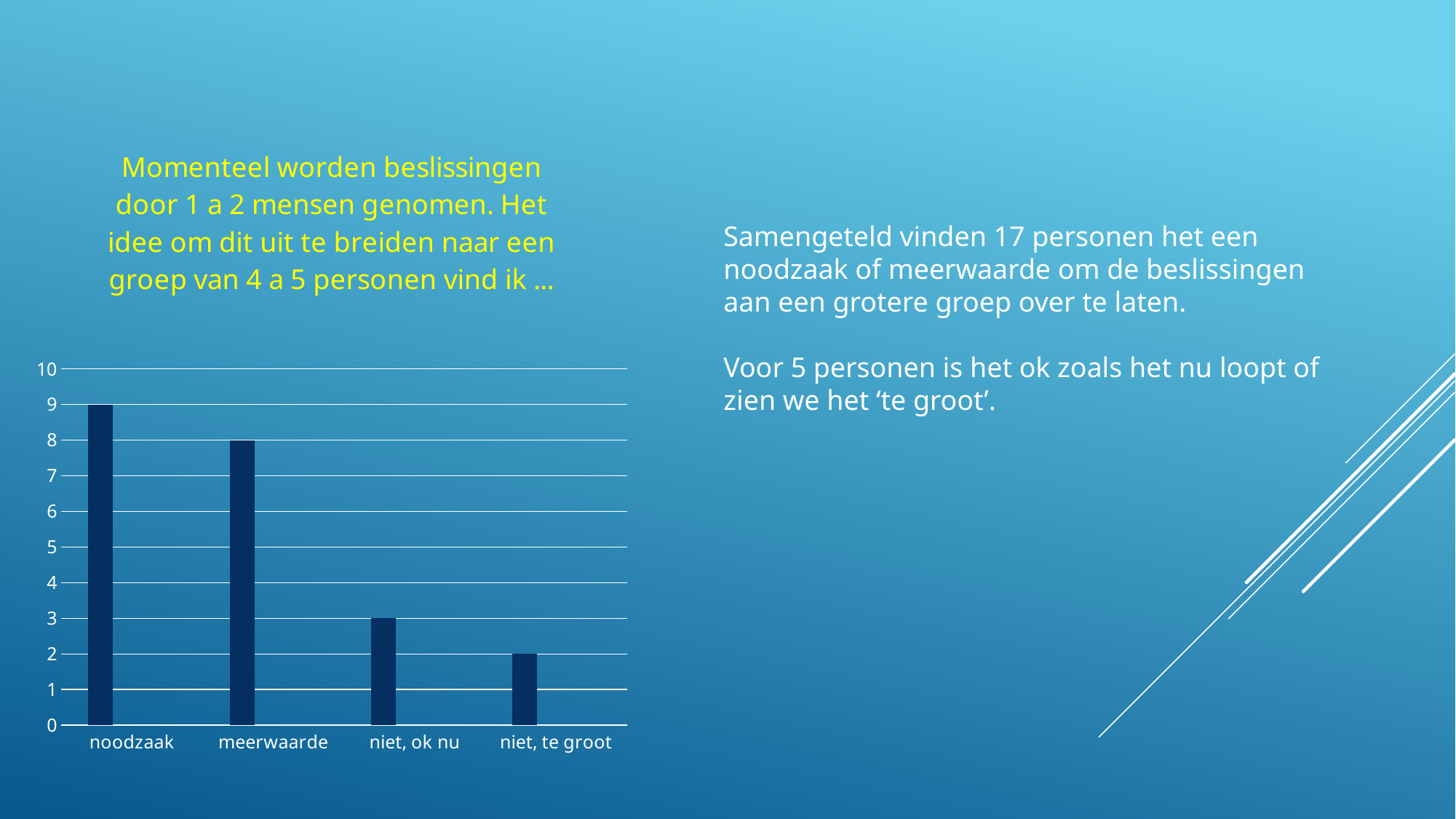
What is the value for 'noodzaak' in the bar chart? 9 What is the value for 'niet, ok nu' in the bar chart? 3 What type of chart is shown on the slide? bar chart Which category has the highest value in the bar chart? noodzaak Do the values rise or fall from left to right across the categories in the bar chart? fall What is the value for 'niet, te groot' in the bar chart? 2 Which category has the lowest value in the bar chart? niet, te groot What is the value for 'meerwaarde' in the bar chart? 8 What is the difference between the values for 'noodzaak' and 'niet, ok nu'? 6 What is the highest value shown on the vertical axis of the bar chart? 10 How many categories does the bar chart show? 4 Which is larger, the value for 'meerwaarde' or the value for 'niet, te groot'? meerwaarde